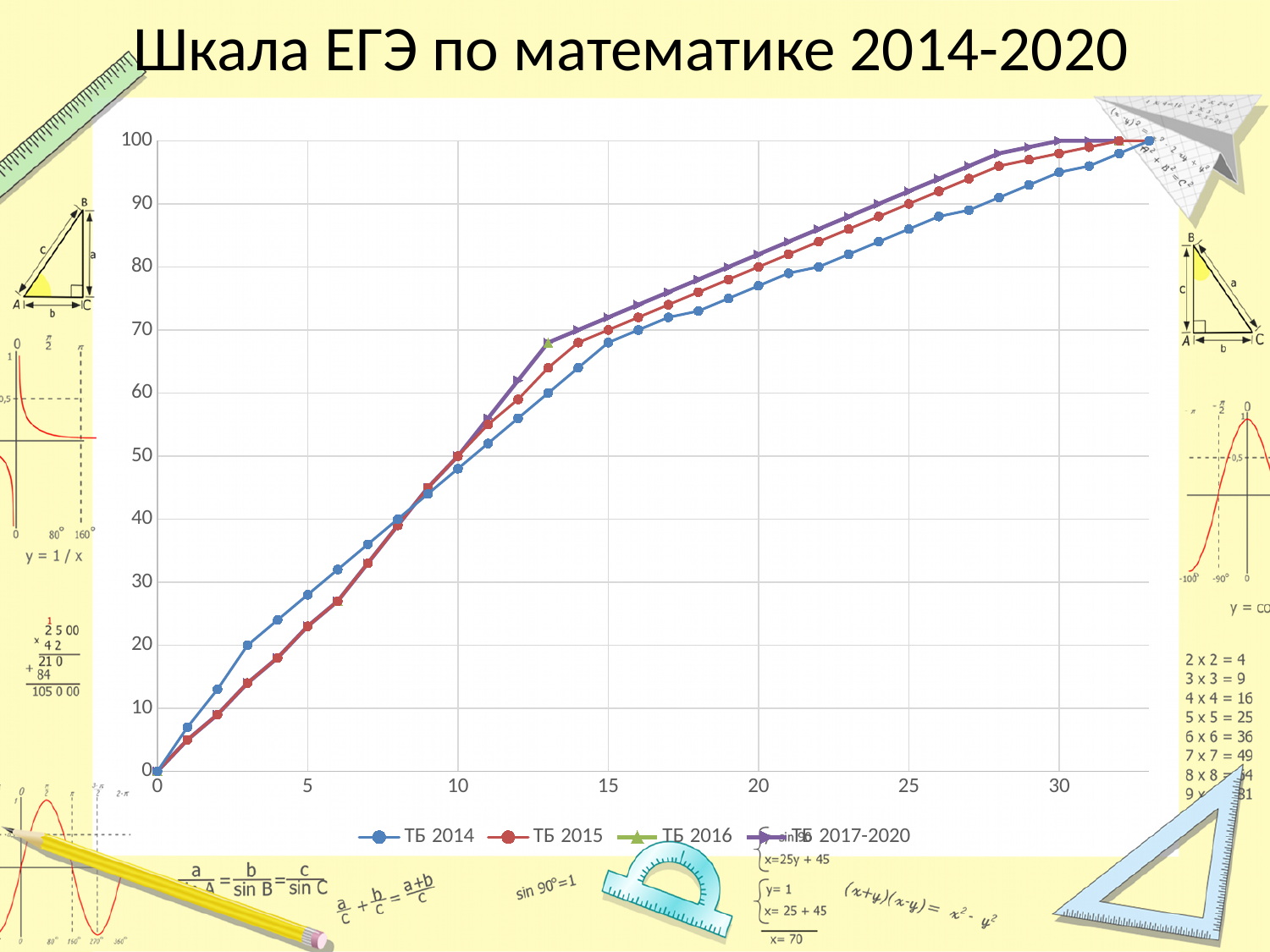
What is the highest value reached by the ТБ 2015 series? 100 Is the value of the ТБ 2014 series at x = 5 greater or less than 30? less At x = 25, which series has the larger value, ТБ 2014 or ТБ 2017-2020? ТБ 2017-2020 At x = 5, which series has the larger value, ТБ 2014 or ТБ 2015? ТБ 2014 How many series does the legend list? 4 What kind of chart is shown on the slide? line chart What is the title of the chart? Шкала ЕГЭ по математике 2014-2020 Do the values of the ТБ 2014 series rise or fall as the x axis increases? rise Is the value of the ТБ 2014 series at x = 30 greater or less than 90? greater What is the value of the ТБ 2014 series at x = 0? 0 Is the value of the ТБ 2014 series at x = 20 greater or less than 70? greater Which series is drawn in blue? ТБ 2014